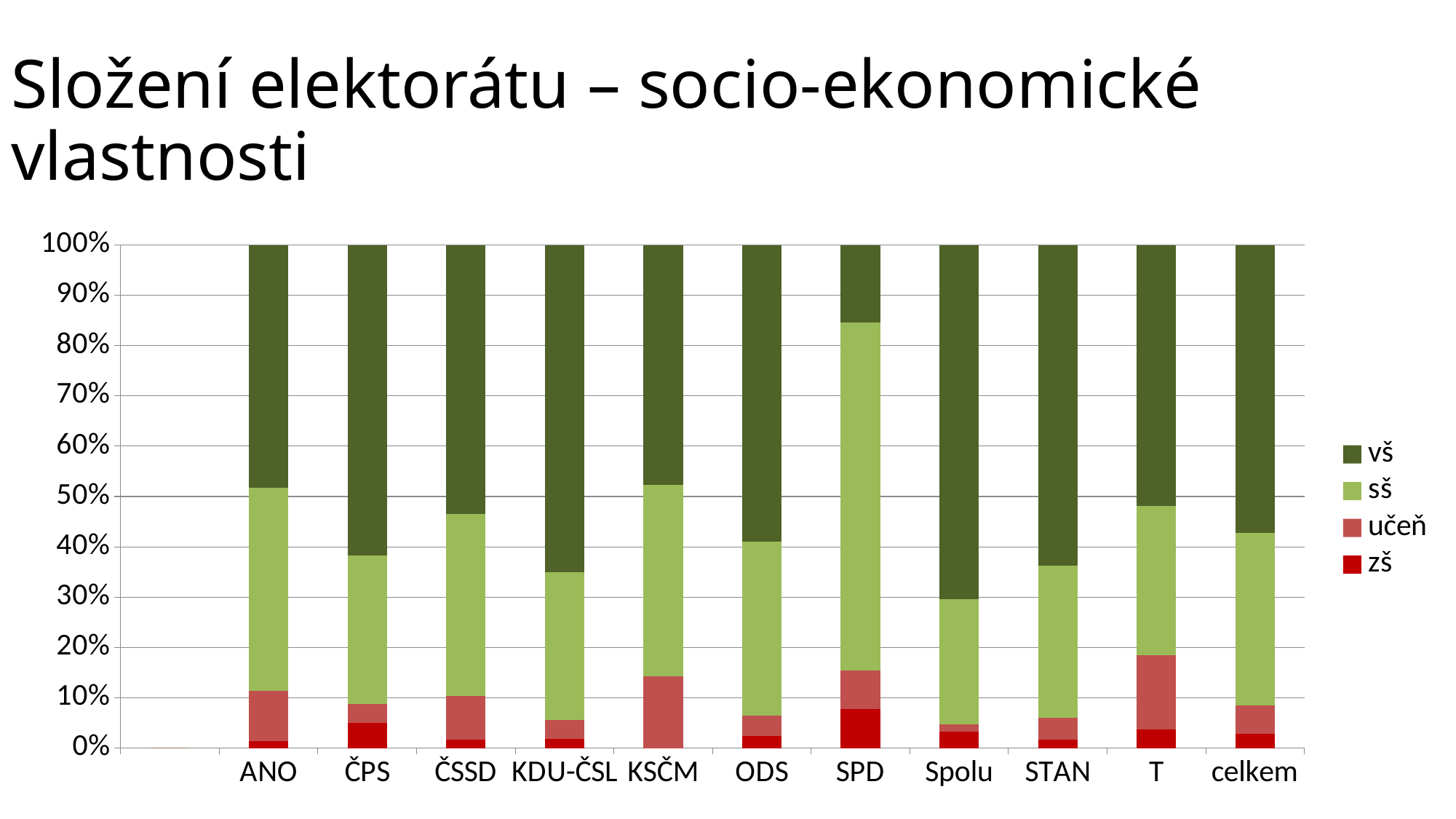
What are the legend entries of the chart, from top to bottom? vš, sš, učeň, zš Which category has the largest zš (red) share? SPD How many categories are shown along the x axis of the chart? 11 Which category has the smallest vš (dark green) share? SPD Is the vš share for SPD greater or less than 20%? less What kind of chart is shown on the slide? stacked bar chart Which has the larger vš share, KDU-ČSL or ANO? KDU-ČSL Which category has the largest sš (light green) share? SPD Is the vš share for Spolu greater or less than 60%? greater Which category has the largest vš (dark green) share? Spolu How many series does the chart's legend list? 4 Is the zš share for SPD greater or less than 5%? greater